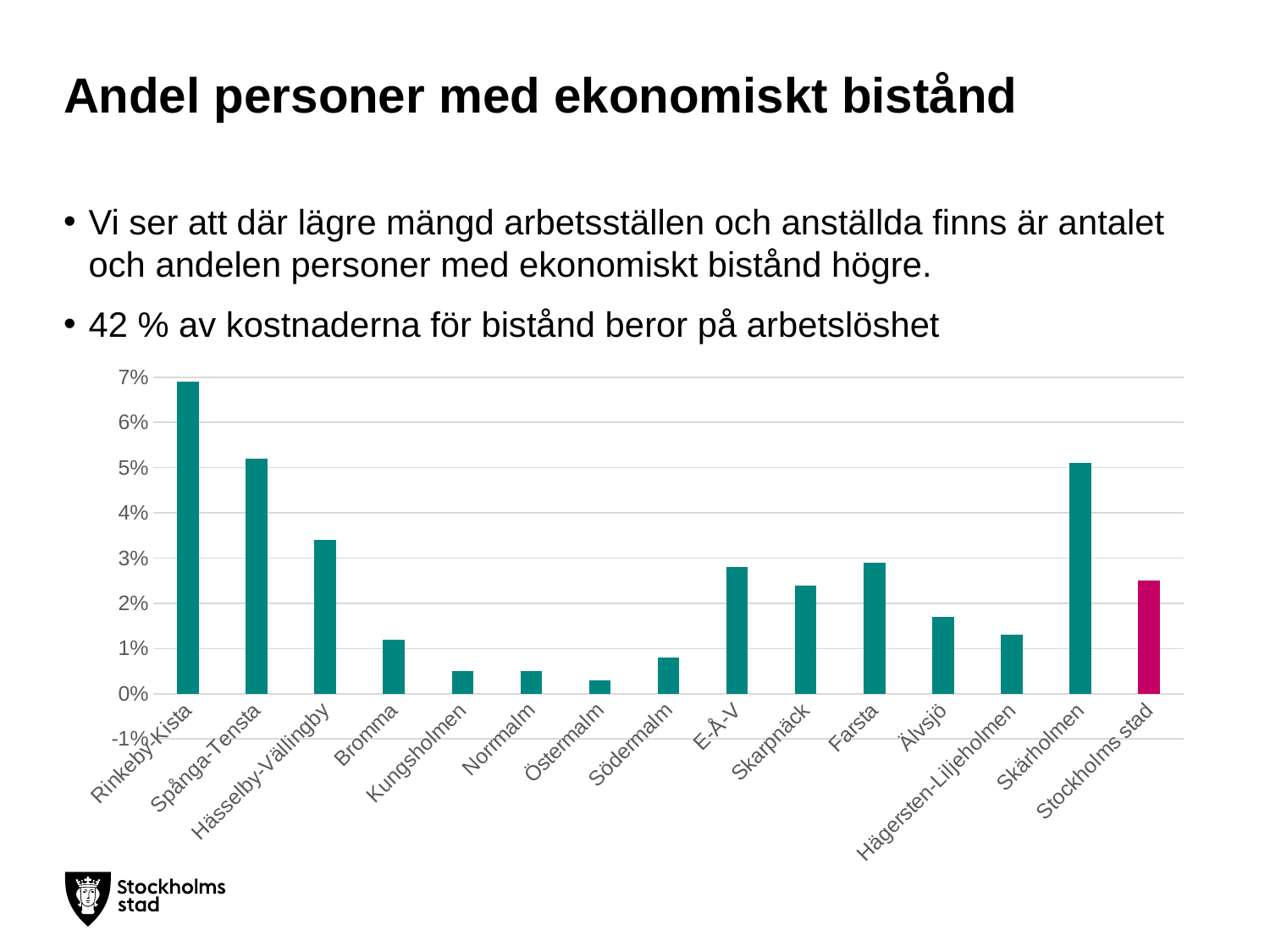
Is the value for Östermalm greater or less than 1%? less Which bar in the chart is shown in a different colour (pink) from the others? Stockholms stad Is the value for Rinkeby-Kista greater or less than 6%? greater How many categories are shown on the x axis of the chart? 15 Which category has the highest share of people with economic assistance? Rinkeby-Kista Which is larger, the value for Hässelby-Vällingby or the value for Farsta? Hässelby-Vällingby Which category has the lowest share of people with economic assistance? Östermalm Which is larger, the value for Skärholmen or the value for Stockholms stad? Skärholmen Is the value for Bromma greater or less than 1%? greater What kind of chart is shown on the slide? bar chart